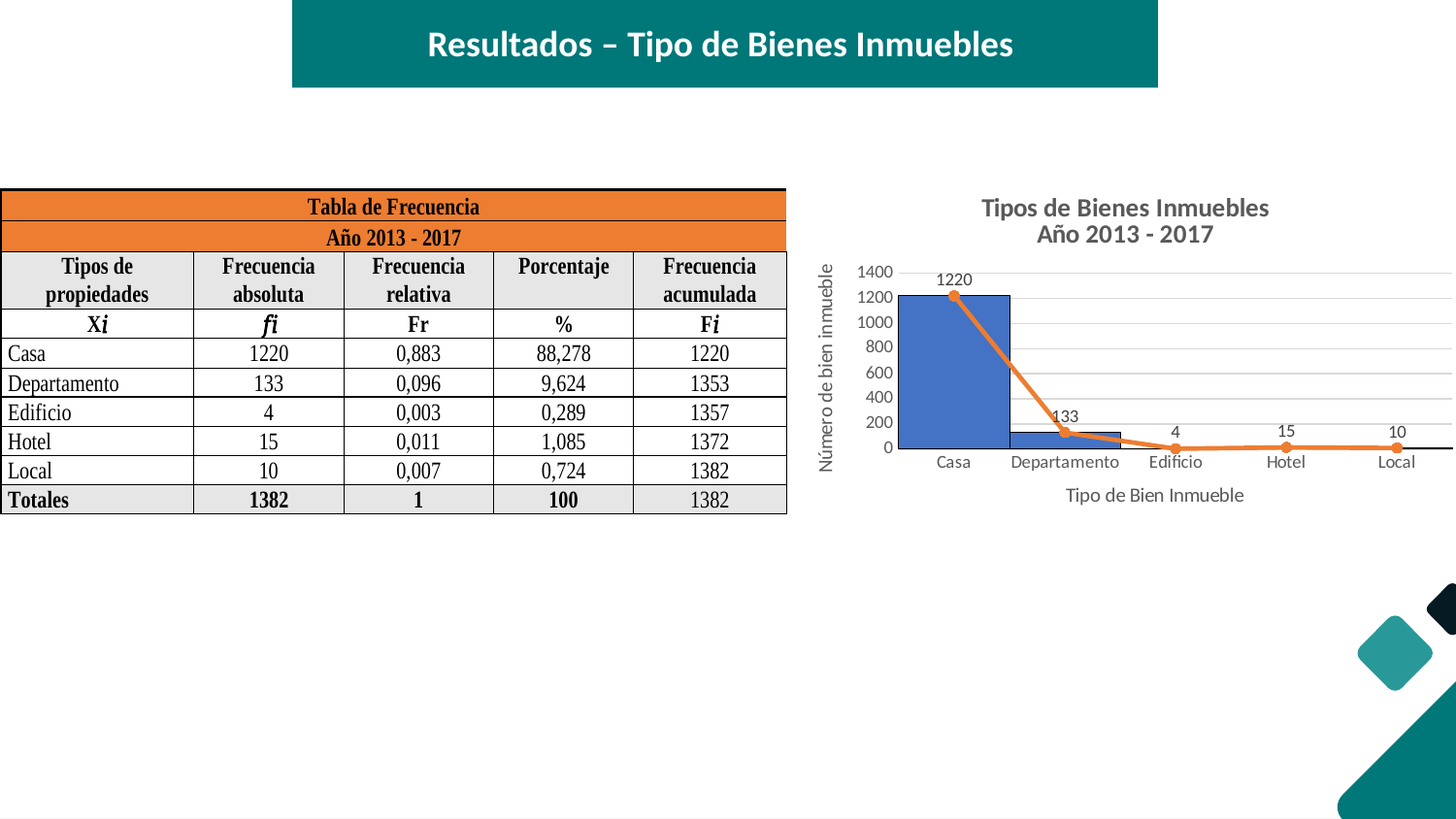
What is the label of the vertical axis of the chart? Número de bien inmueble What is the value for Departamento in the chart? 133 What is the value for Local in the chart? 10 Which category has the highest value in the chart? Casa What is the title of the chart? Tipos de Bienes Inmuebles Año 2013 - 2017 Which is larger, the value for Hotel or the value for Edificio? Hotel What is the value for Hotel in the chart? 15 How many categories are shown on the x axis of the chart? 5 Which category has the lowest value in the chart? Edificio What is the value for Casa in the chart? 1220 What is the difference between the values for Casa and Departamento? 1087 What is the difference between the values for Hotel and Local? 5